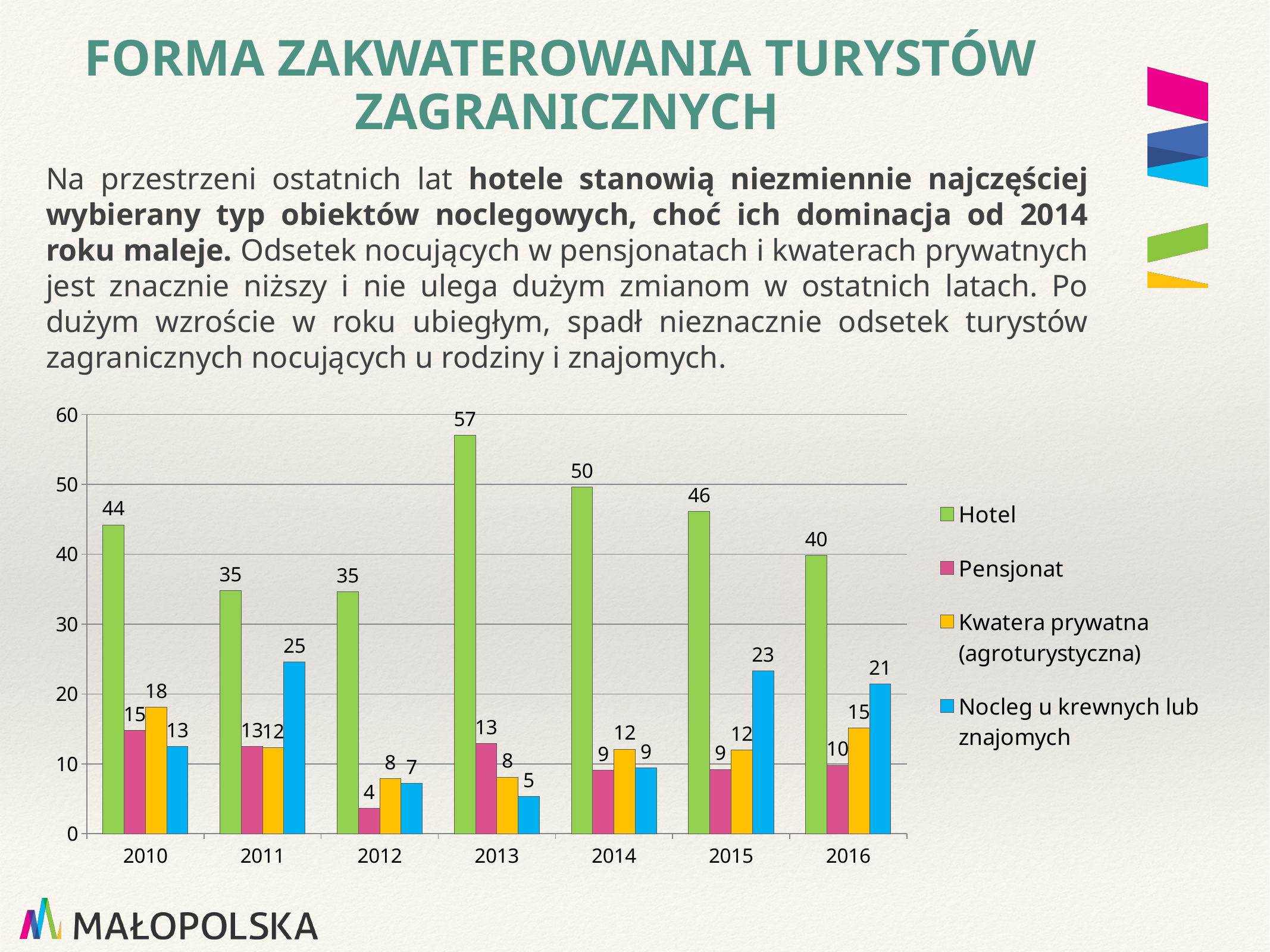
What is the value for Nocleg u krewnych lub znajomych in 2011? 25 How many series does the legend list? 4 How many years are shown on the x axis? 7 Which is larger in 2015: Kwatera prywatna (agroturystyczna) or Nocleg u krewnych lub znajomych? Nocleg u krewnych lub znajomych What is the difference between the Hotel values in 2013 and 2016? 17 What is the value for Pensjonat in 2012? 4 What is the value for Kwatera prywatna (agroturystyczna) in 2016? 15 What is the value for Hotel in 2013? 57 In which year is the Nocleg u krewnych lub znajomych value lowest? 2013 What kind of chart is shown on the slide? bar chart Does the Hotel value rise or fall from 2013 to 2016? fall In which year is the Hotel value highest? 2013